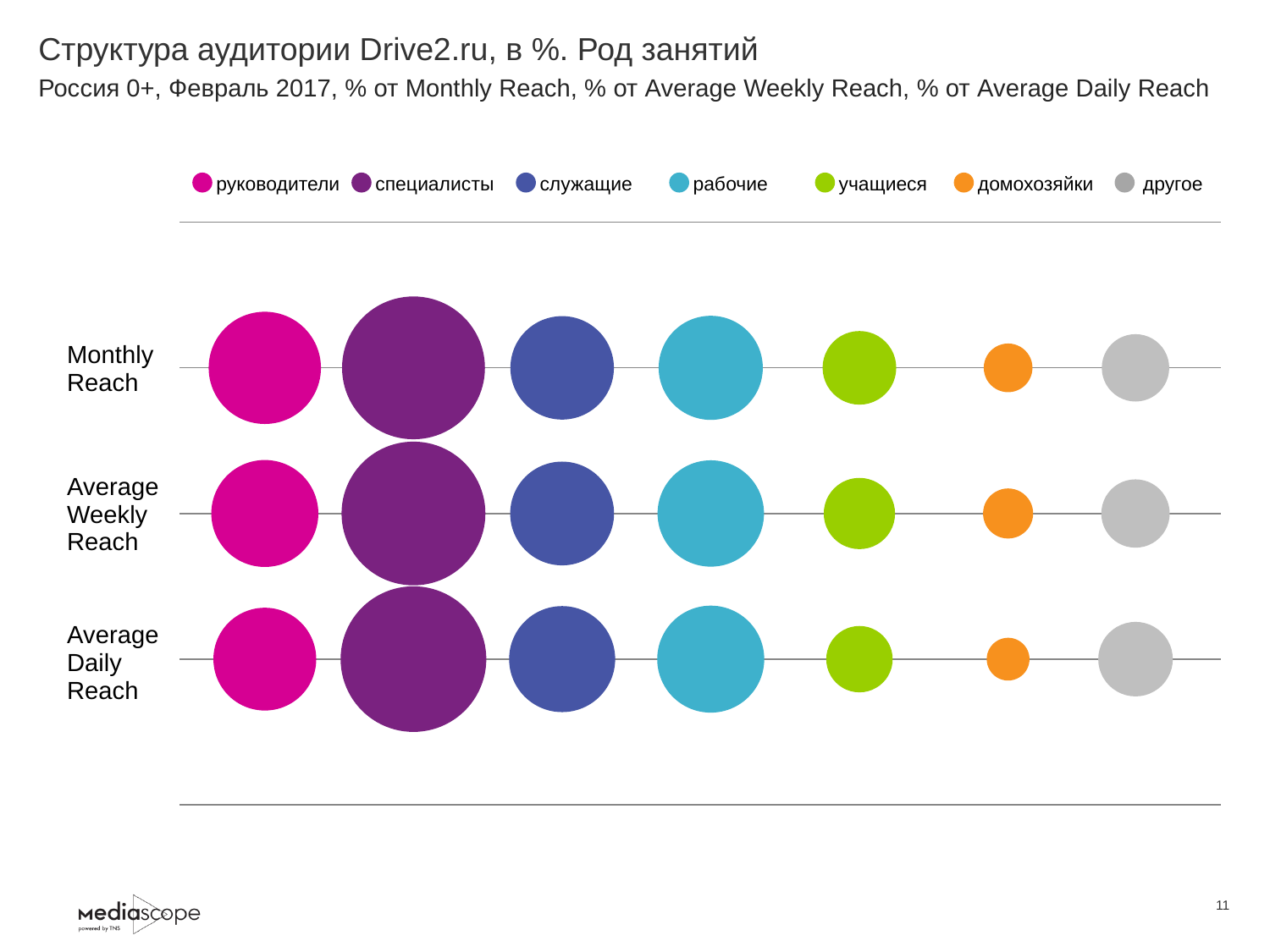
In the Average Weekly Reach row, which bubble is larger: рабочие or домохозяйки? рабочие What is the title of the chart on the slide? Структура аудитории Drive2.ru, в %. Род занятий In the Average Daily Reach row, which bubble is larger: руководители or учащиеся? руководители Which occupation group has the largest bubble in the Average Weekly Reach row? специалисты In the Monthly Reach row, which bubble is larger: специалисты or домохозяйки? специалисты Which occupation group has the smallest bubble in the Average Daily Reach row? домохозяйки What kind of chart is shown on the slide? Bubble chart How many series does the legend list? 7 Which occupation group has the smallest bubble in the Monthly Reach row? домохозяйки Which occupation group has the largest bubble in the Monthly Reach row? специалисты Which legend entry is shown in orange? домохозяйки How many reach rows (categories) are plotted on the chart? 3